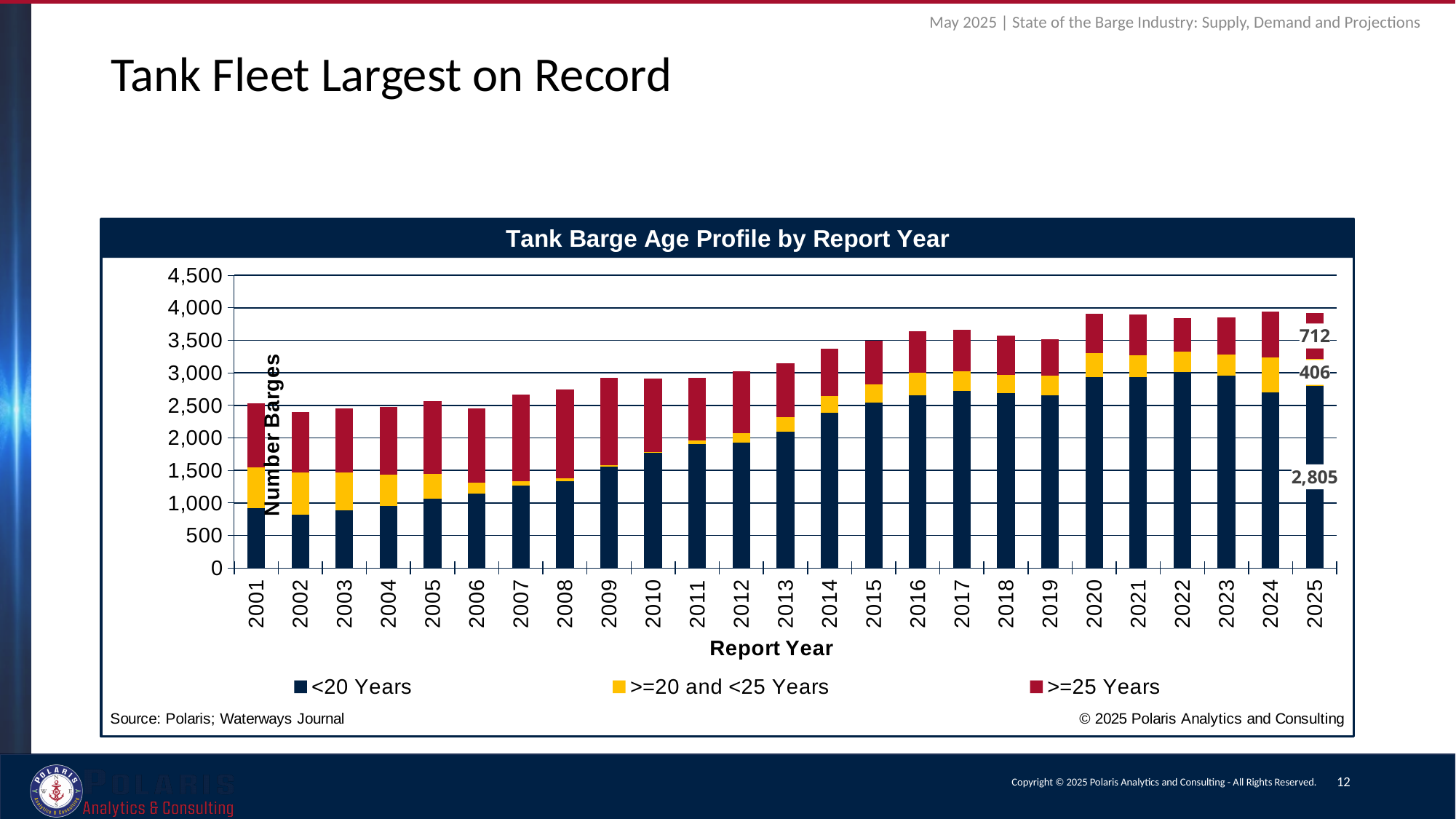
What is the total number of tank barges in the 2025 stacked bar? 3,923 What is the title of the chart? Tank Barge Age Profile by Report Year How many series does the legend list? 3 What kind of chart is shown on the slide? Stacked bar chart What is the value for the >=25 Years series in 2025? 712 Is the total bar height for 2001 greater or less than 3,000? less What is the value for the <20 Years series in 2025? 2,805 Does the <20 Years series generally rise or fall from 2001 to 2025? rise How many report years are shown on the x axis? 25 In 2025, which is larger: the <20 Years value or the >=25 Years value? <20 Years What is the difference between the >=25 Years value and the >=20 and <25 Years value in 2025? 306 What is the value for the >=20 and <25 Years series in 2025? 406